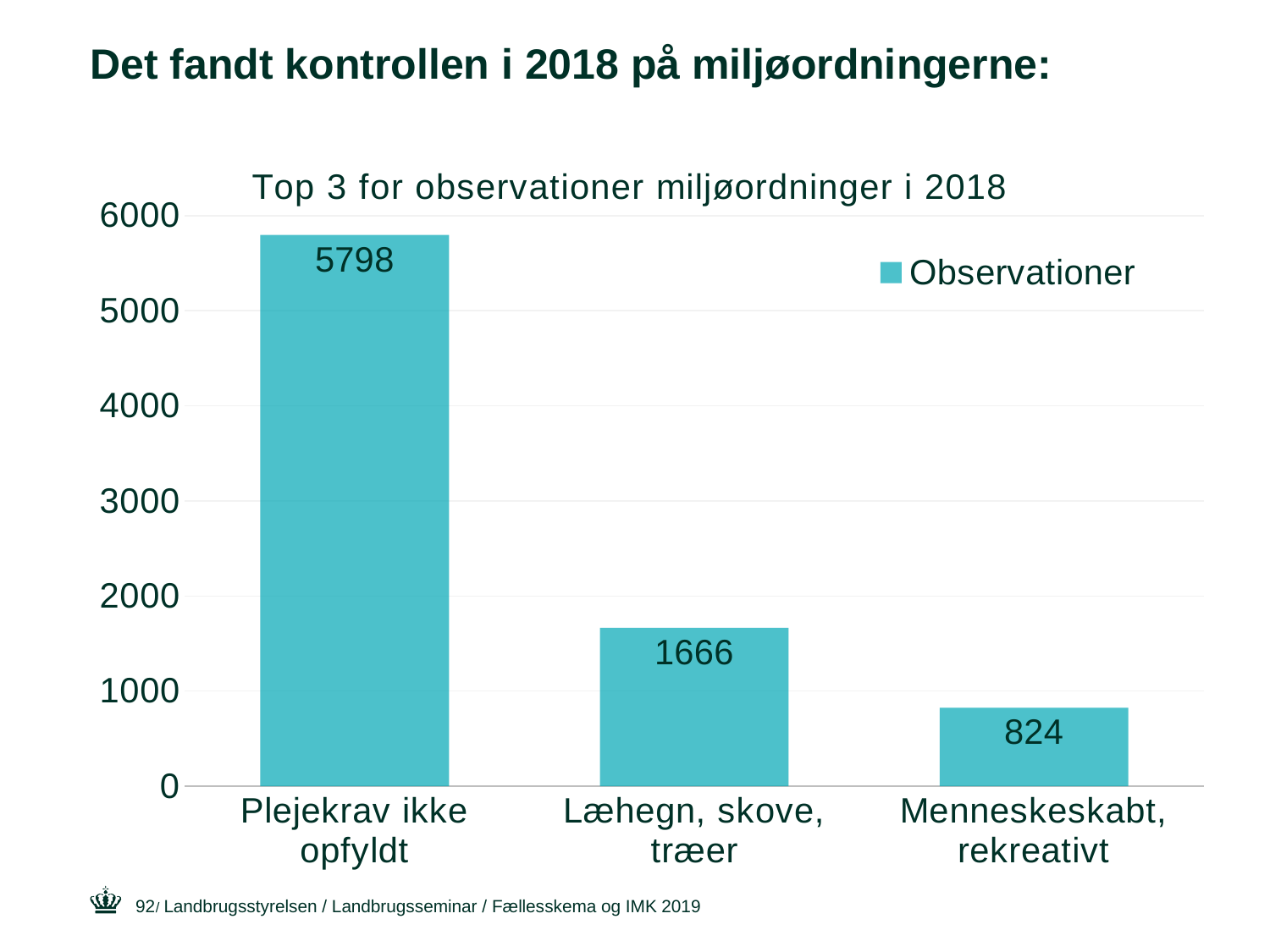
What is the value for "Menneskeskabt, rekreativt"? 824 What is the difference between the values for "Plejekrav ikke opfyldt" and "Læhegn, skove, træer"? 4132 What is the value for "Plejekrav ikke opfyldt"? 5798 Is the value for "Menneskeskabt, rekreativt" greater or less than 1000? less Which category has the highest number of observations? Plejekrav ikke opfyldt What kind of chart is shown on the slide? bar chart What is the title of the chart? Top 3 for observationer miljøordninger i 2018 How many categories are shown in the chart? 3 Which category has the lowest number of observations? Menneskeskabt, rekreativt Which is larger, the value for "Læhegn, skove, træer" or "Menneskeskabt, rekreativt"? Læhegn, skove, træer What is the value for "Læhegn, skove, træer"? 1666 What is the difference between the values for "Læhegn, skove, træer" and "Menneskeskabt, rekreativt"? 842